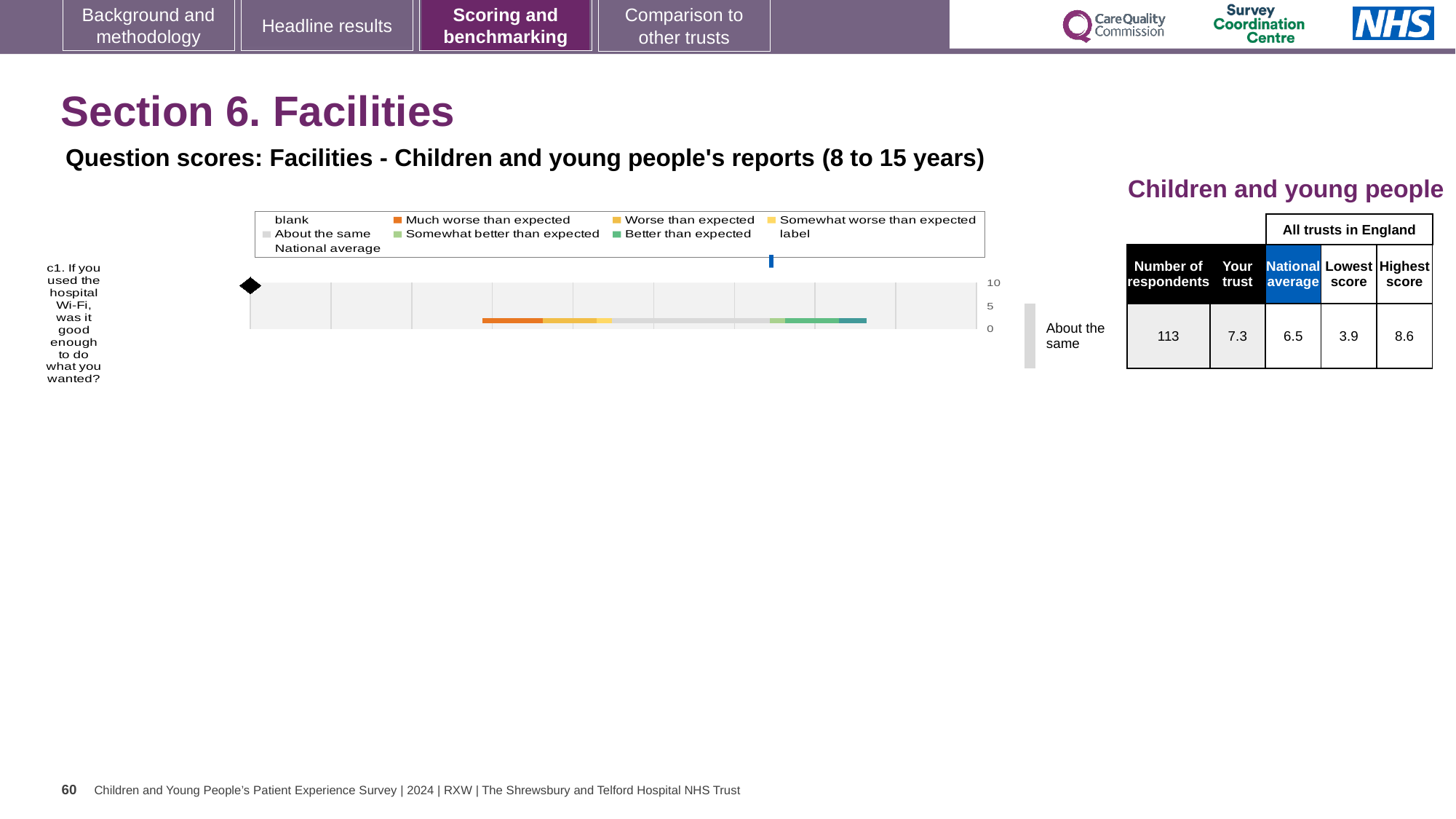
What is the highest score among all trusts in England for question c1? 8.6 How many respondents answered question c1 about the hospital Wi-Fi? 113 Which benchmark category is the trust's score for question c1 placed in? About the same What is the 'Your trust' score for question c1 (hospital Wi-Fi)? 7.3 How many survey questions are plotted in the chart on this slide? 1 What is the national average score for question c1 (hospital Wi-Fi)? 6.5 By how much does the trust's score for question c1 exceed the national average? 0.8 What kind of chart is used to show the question score for c1 on this slide? bar chart How many entries does the chart legend list? 9 What is the difference between the highest and lowest scores for question c1 across all trusts in England? 4.7 What is the lowest score among all trusts in England for question c1? 3.9 For question c1, which is larger: the trust's score or the national average? Your trust